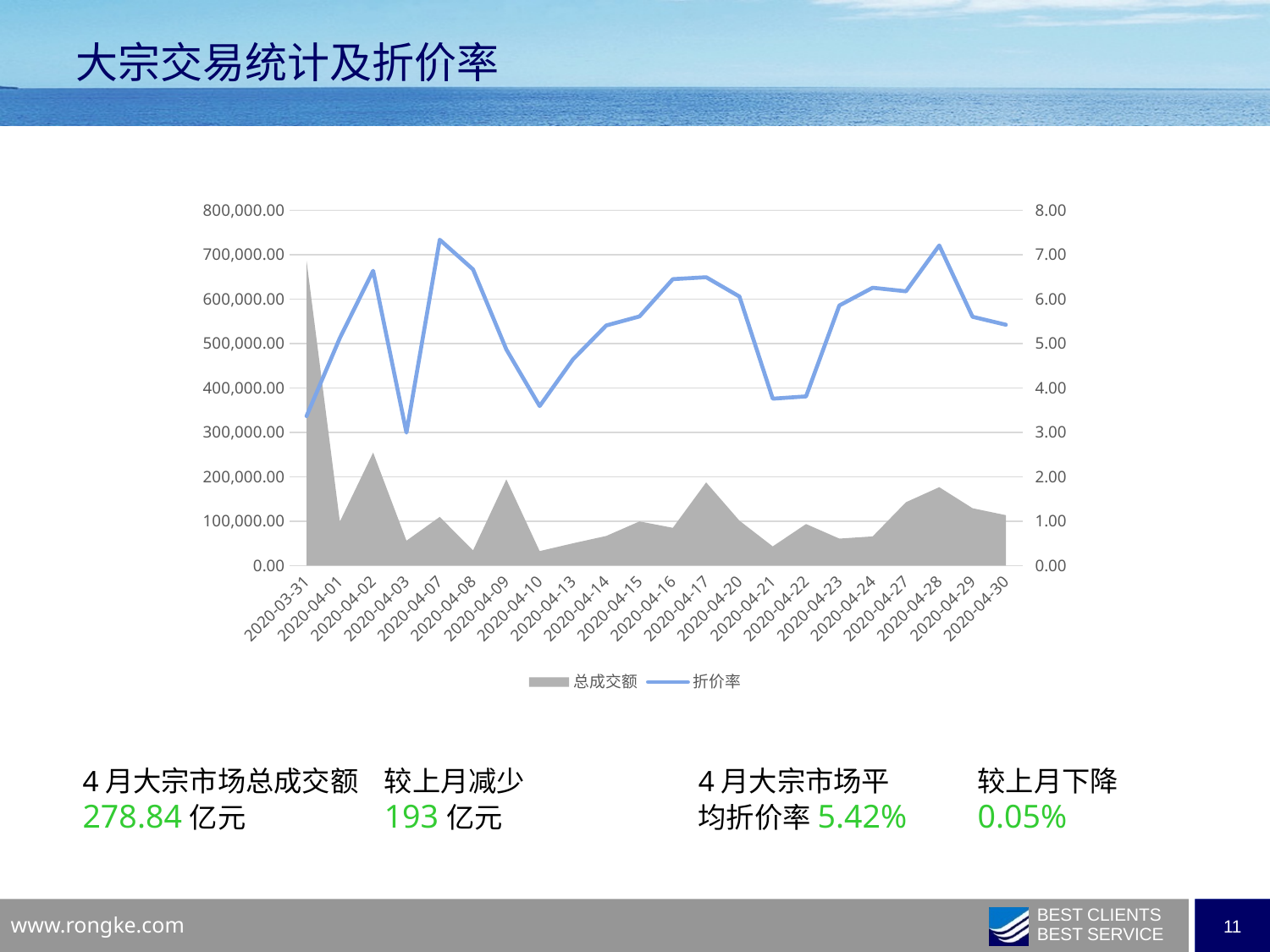
Is the 折价率 value for 2020-04-16 greater or less than 6.00? greater Is the 总成交额 value for 2020-03-31 greater or less than 600,000.00? greater What are the two series named in the legend? 总成交额 and 折价率 Which date has the larger 总成交额, 2020-04-02 or 2020-04-17? 2020-04-02 Does 折价率 rise or fall from 2020-04-28 to 2020-04-30? fall On which date is 总成交额 highest? 2020-03-31 How many dates are shown on the x axis of the chart? 22 What is the title of the chart? 大宗交易统计及折价率 On which date is 折价率 lowest? 2020-04-03 Is the 折价率 value for 2020-04-03 greater or less than 4.00? less How many series does the chart legend list? 2